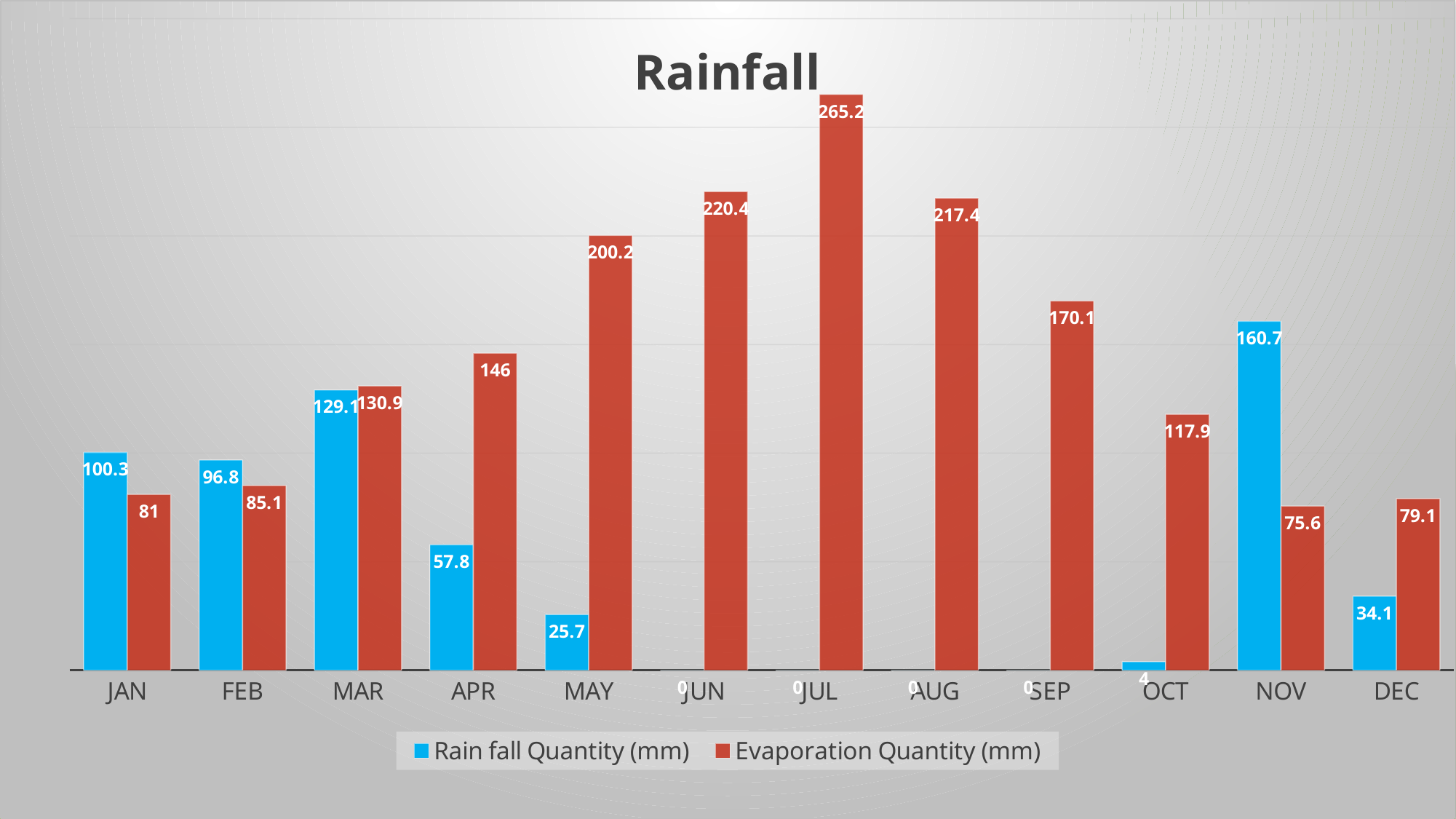
What type of chart is shown on the slide? Bar chart What is the difference between the Evaporation Quantity (mm) and the Rain fall Quantity (mm) in APR? 88.2 How many series does the legend list? 2 What is the Evaporation Quantity (mm) for SEP? 170.1 What is the Rain fall Quantity (mm) for NOV? 160.7 Which month has the highest Evaporation Quantity (mm)? JUL Which month has the lowest Evaporation Quantity (mm)? NOV How many months are shown on the x axis? 12 What is the Evaporation Quantity (mm) for JUL? 265.2 In JAN, which is larger: the Rain fall Quantity (mm) or the Evaporation Quantity (mm)? Rain fall Quantity (mm) Which month has the highest Rain fall Quantity (mm)? NOV What is the Rain fall Quantity (mm) for MAY? 25.7